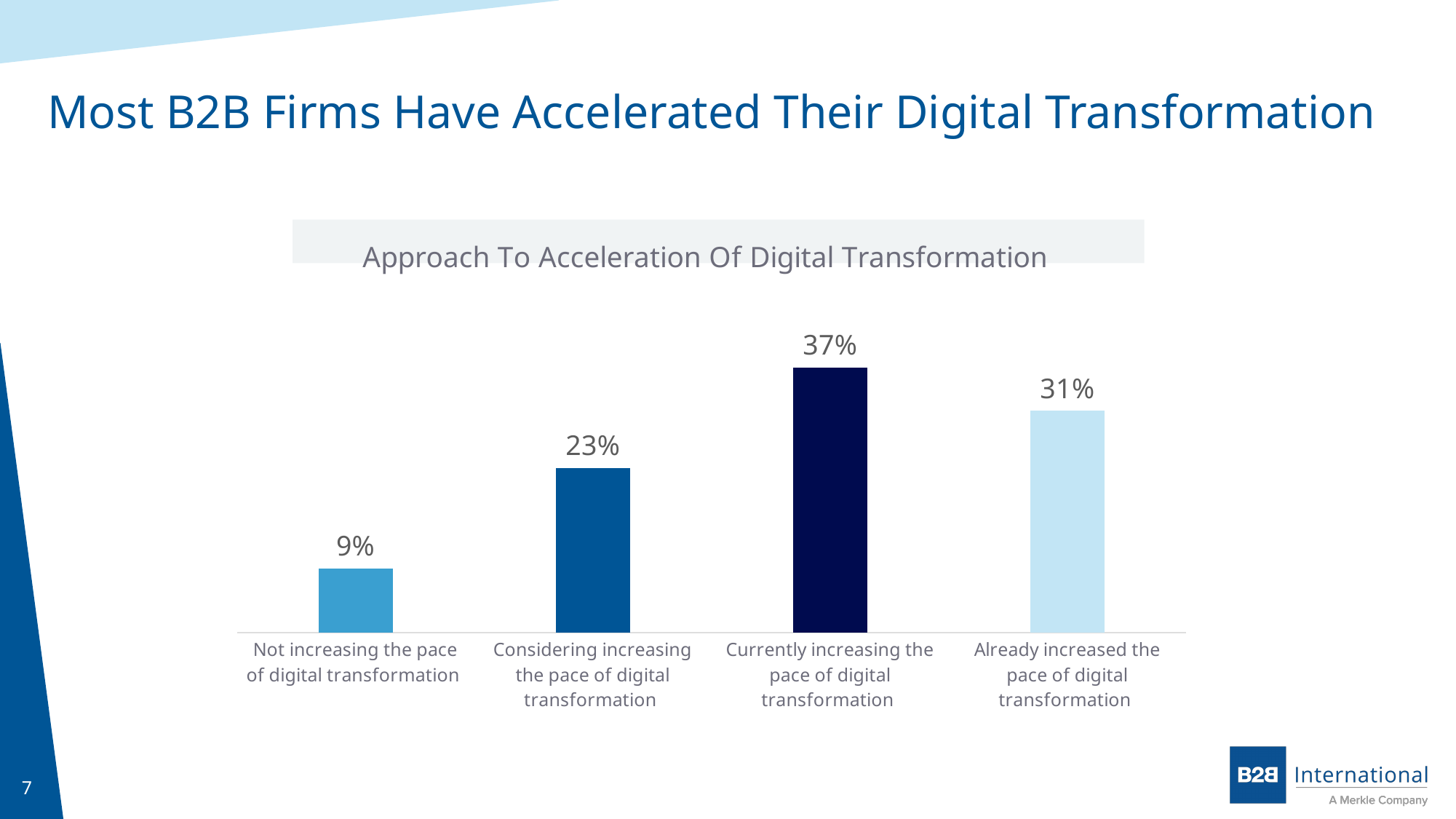
What is the difference between 'Currently increasing the pace of digital transformation' and 'Already increased the pace of digital transformation'? 6% What percentage of firms are currently increasing the pace of digital transformation? 37% What percentage of firms are considering increasing the pace of digital transformation? 23% What is the difference between 'Considering increasing the pace of digital transformation' and 'Not increasing the pace of digital transformation'? 14% What is the value for 'Already increased the pace of digital transformation'? 31% Which category has the lowest value? Not increasing the pace of digital transformation Which is larger: 'Considering increasing the pace of digital transformation' or 'Already increased the pace of digital transformation'? Already increased the pace of digital transformation What type of chart is shown on the slide? Bar chart What is the value for 'Not increasing the pace of digital transformation'? 9% What is the title of the chart? Approach To Acceleration Of Digital Transformation Which category has the highest value? Currently increasing the pace of digital transformation How many categories are shown in the chart? 4